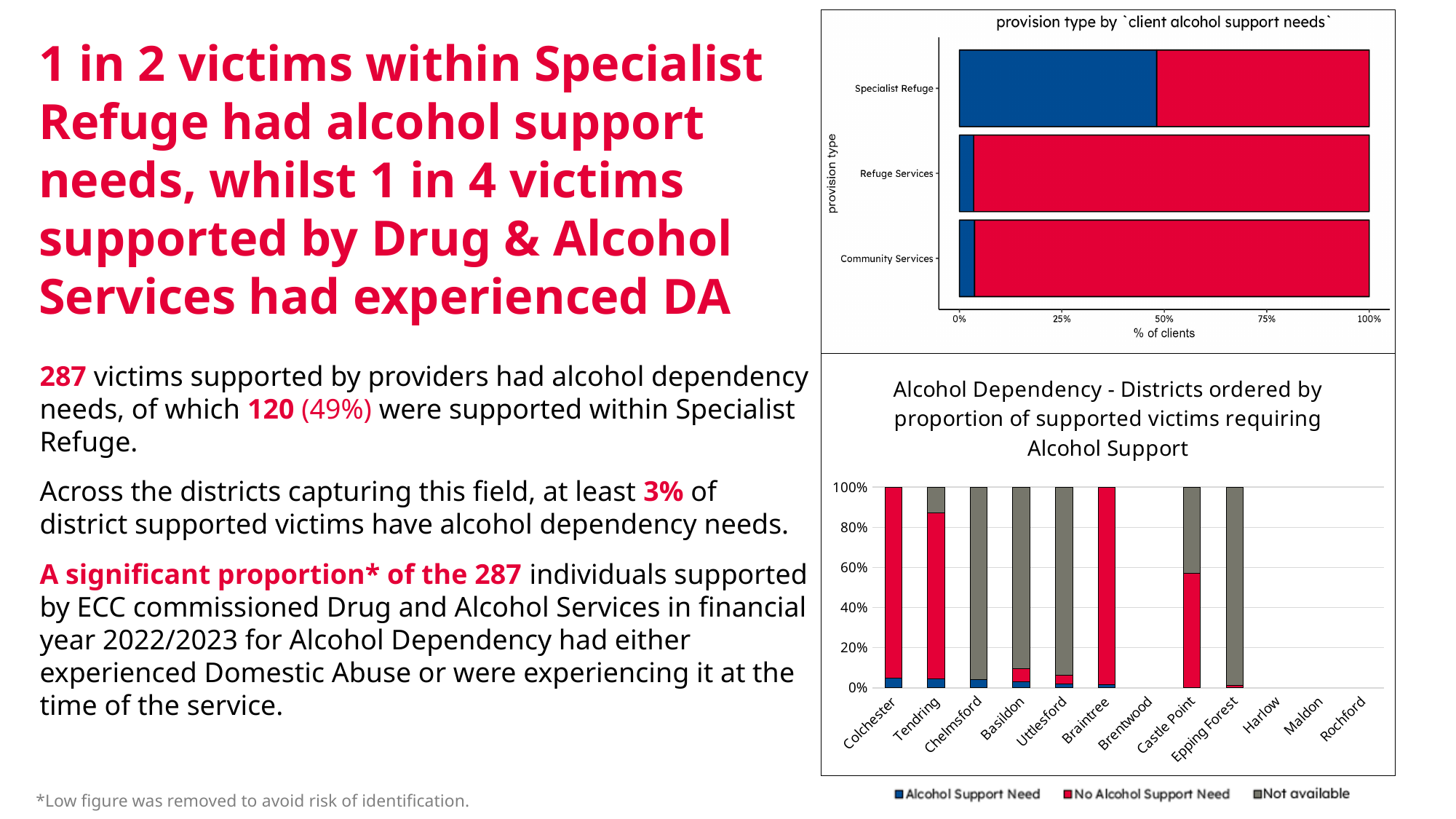
In the bottom 'Alcohol Dependency' chart, which colour represents 'Not available'? grey How many series does the legend of the bottom 'Alcohol Dependency' chart list? 3 How many provision types are shown on the y axis of the top-right chart? 3 What kind of chart is the top-right chart titled 'provision type by `client alcohol support needs`'? bar chart In the top-right chart, which provision type has the largest blue (alcohol support need) share? Specialist Refuge In the bottom 'Alcohol Dependency' chart, which has the larger 'No Alcohol Support Need' portion, Tendring or Chelmsford? Tendring In the top-right chart, is the blue share for Refuge Services greater or less than 25%? less In the bottom 'Alcohol Dependency' chart, is the 'No Alcohol Support Need' portion for Colchester greater or less than 80%? greater How many districts are listed on the x axis of the bottom 'Alcohol Dependency' chart? 12 In the bottom 'Alcohol Dependency' chart, is the 'Not available' portion for Chelmsford greater or less than 80%? greater What is the x-axis label of the top-right chart? % of clients